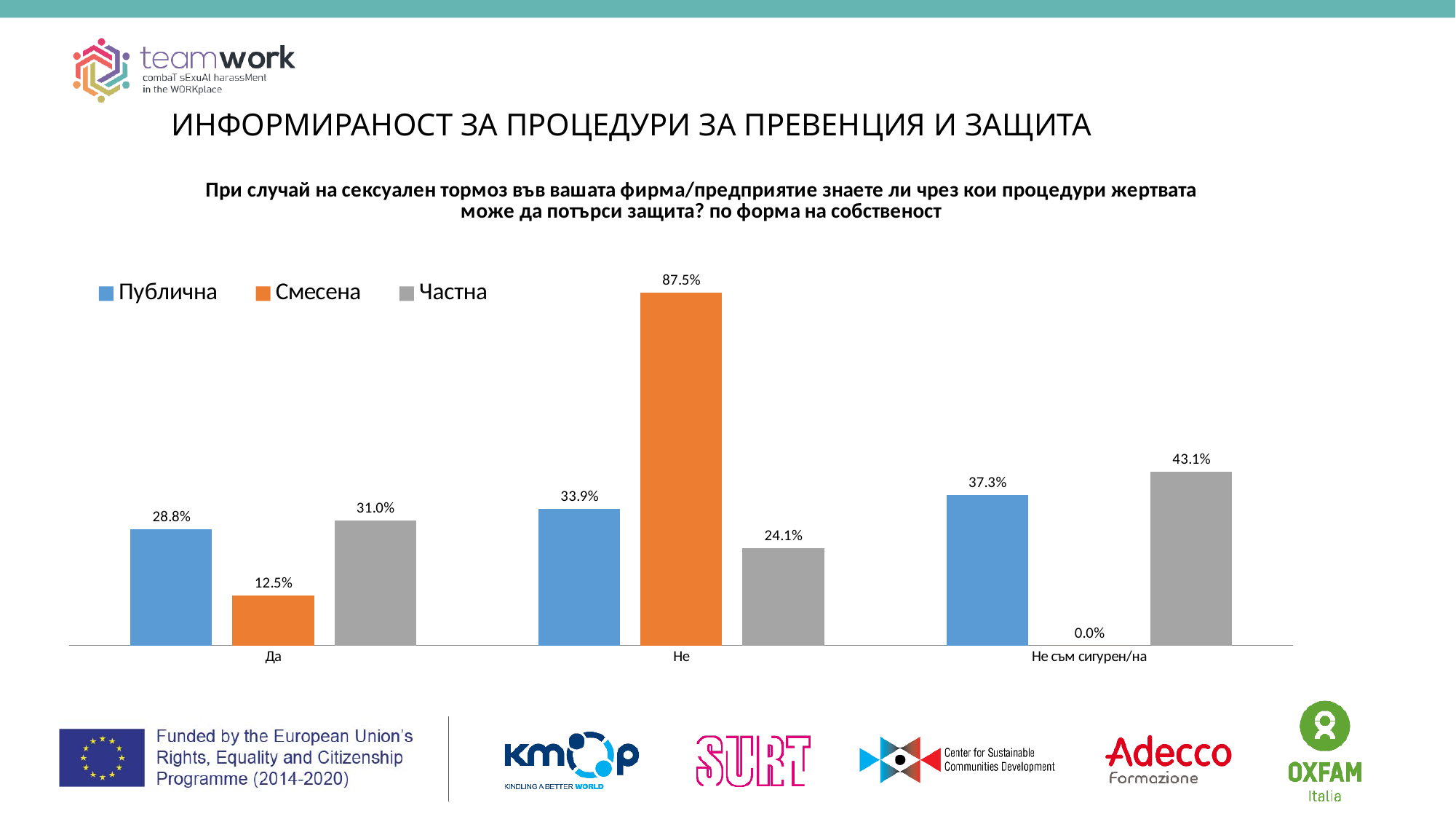
Which series has the lowest value in the Да category? Смесена What is the difference between the Частна and Публична values in the Да category? 2.2% What colour represents the Смесена series? Orange What is the value for Частна in the Не съм сигурен/на category? 43.1% Which series has the highest value in the Не category? Смесена How many series does the legend list? 3 What kind of chart is shown on the slide? Bar chart Which is larger: Публична in Не or Частна in Не? Публична in Не What is the value for Смесена in the Не category? 87.5% How many categories are shown on the x axis? 3 What is the value for Публична in the Да category? 28.8% What is the value for Смесена in the Не съм сигурен/на category? 0.0%